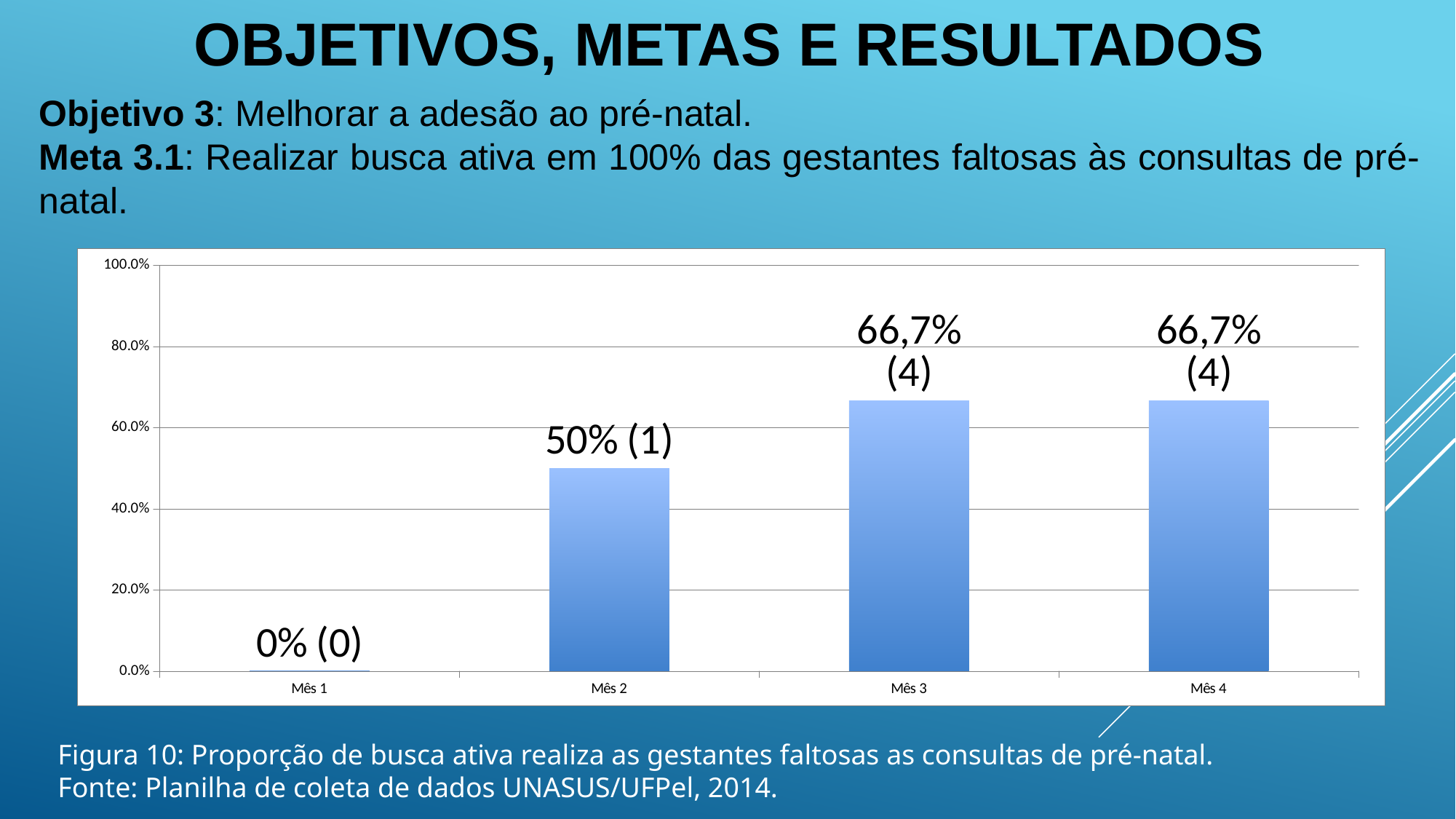
What kind of chart is shown on the slide? Bar chart What value is shown for Mês 1? 0% (0) Which month has the lowest value? Mês 1 What is the highest value shown on the y axis? 100.0% What value is shown for Mês 2? 50% (1) How many months (categories) are shown on the x axis? 4 Which is larger, the value for Mês 2 or the value for Mês 3? Mês 3 Is the value for Mês 2 greater or less than 40.0%? greater What value is shown for Mês 3? 66,7% (4) Is the value for Mês 4 greater or less than 80.0%? less Do the values rise or fall from Mês 1 to Mês 3? Rise What percentage is labelled on the bar for Mês 4? 66,7%